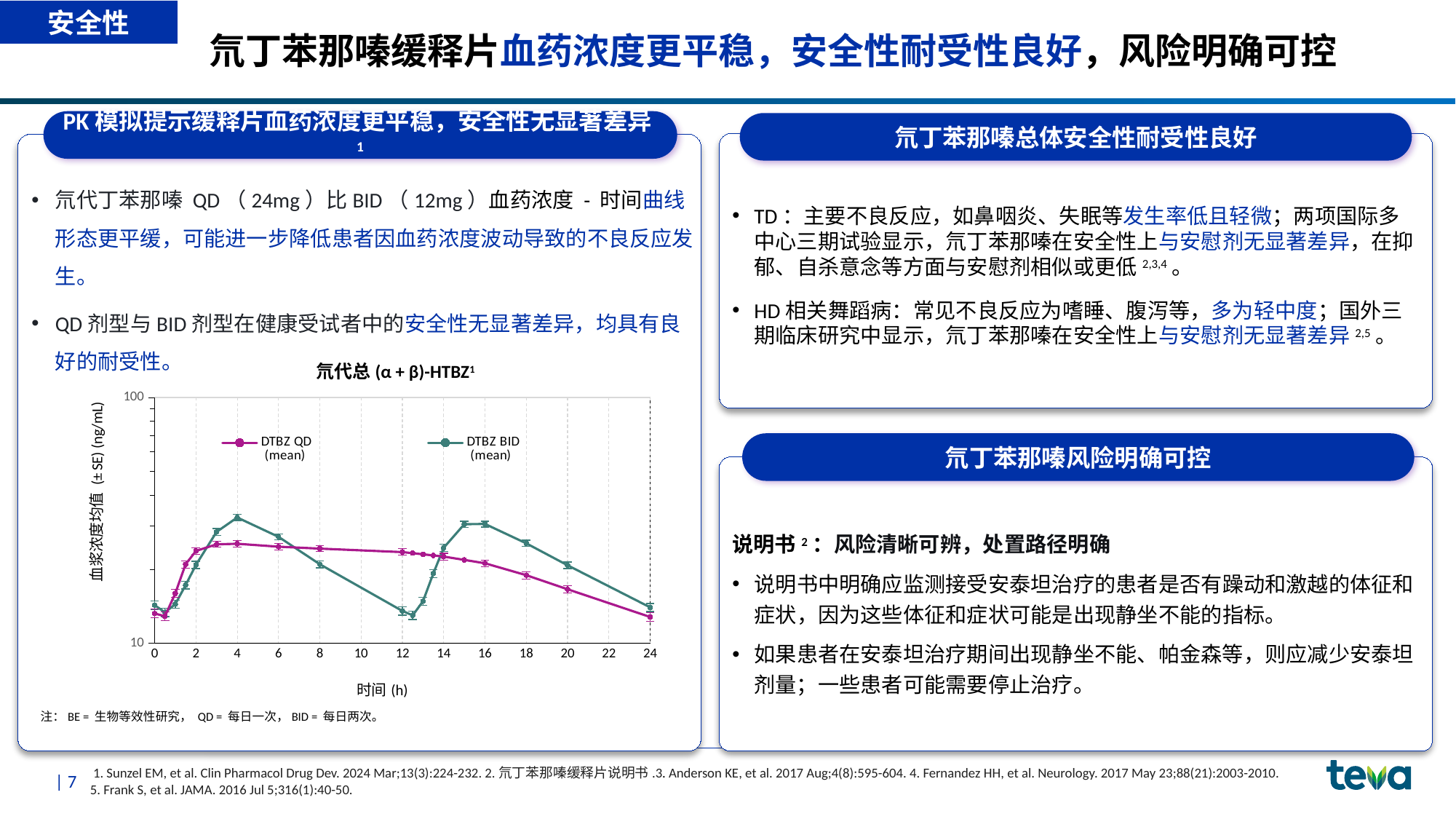
How many series does the chart legend list? 2 Which series reaches the highest peak concentration on the chart? DTBZ BID At 16 h, which series has the higher plasma concentration, DTBZ QD or DTBZ BID? DTBZ BID At 4 h, which series has the higher plasma concentration, DTBZ QD or DTBZ BID? DTBZ BID Is the value for DTBZ QD at 0 h greater or less than 10? greater How many tick labels are shown on the x axis (时间 (h))? 13 What is the title of the chart? 氘代总 (α + β)-HTBZ Does the DTBZ QD series rise or fall between 4 h and 24 h? fall At 12 h, which series has the higher plasma concentration, DTBZ QD or DTBZ BID? DTBZ QD What kind of chart is shown on the slide? line chart What are the two series named in the chart legend? DTBZ QD (mean) and DTBZ BID (mean) Is the value for DTBZ BID at 4 h greater or less than 100? less